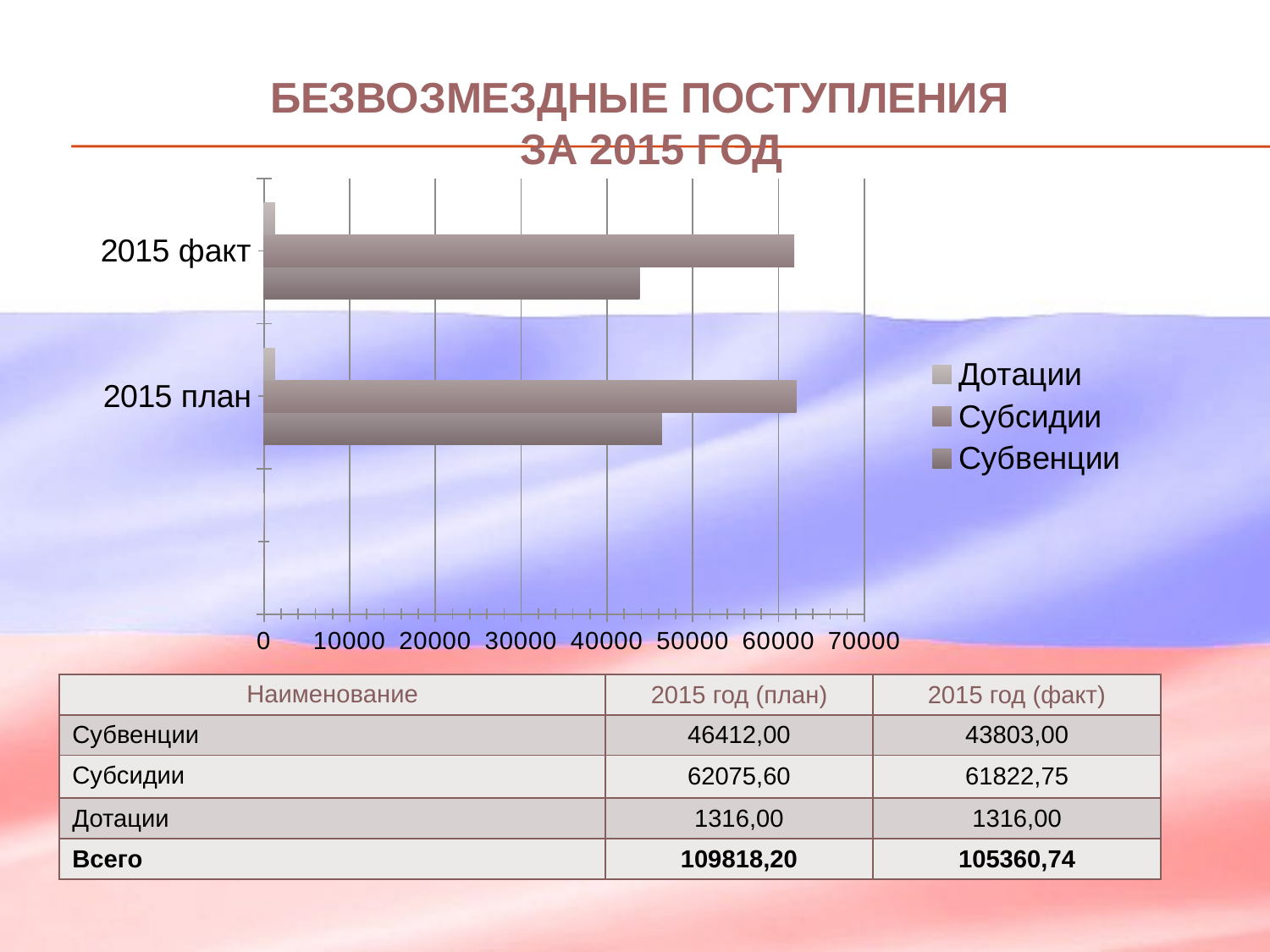
What is the difference between Субвенции for 2015 план and Субвенции for 2015 факт? 2609,00 How many series does the chart legend list? 3 What is the value of Субсидии for 2015 план? 62075,60 Is the value of Субвенции for 2015 план greater or less than 40000? greater What is the value of Субвенции for 2015 факт? 43803,00 How many categories are shown on the chart's vertical axis? 2 What is the value of Дотации for 2015 факт? 1316,00 What kind of chart is shown on the slide? bar chart Which series has the longest bar for 2015 факт? Субсидии What is the title of the slide containing the chart? БЕЗВОЗМЕЗДНЫЕ ПОСТУПЛЕНИЯ ЗА 2015 ГОД Which is larger: Субвенции for 2015 план or Субвенции for 2015 факт? 2015 план Which series has the shortest bar for 2015 план? Дотации